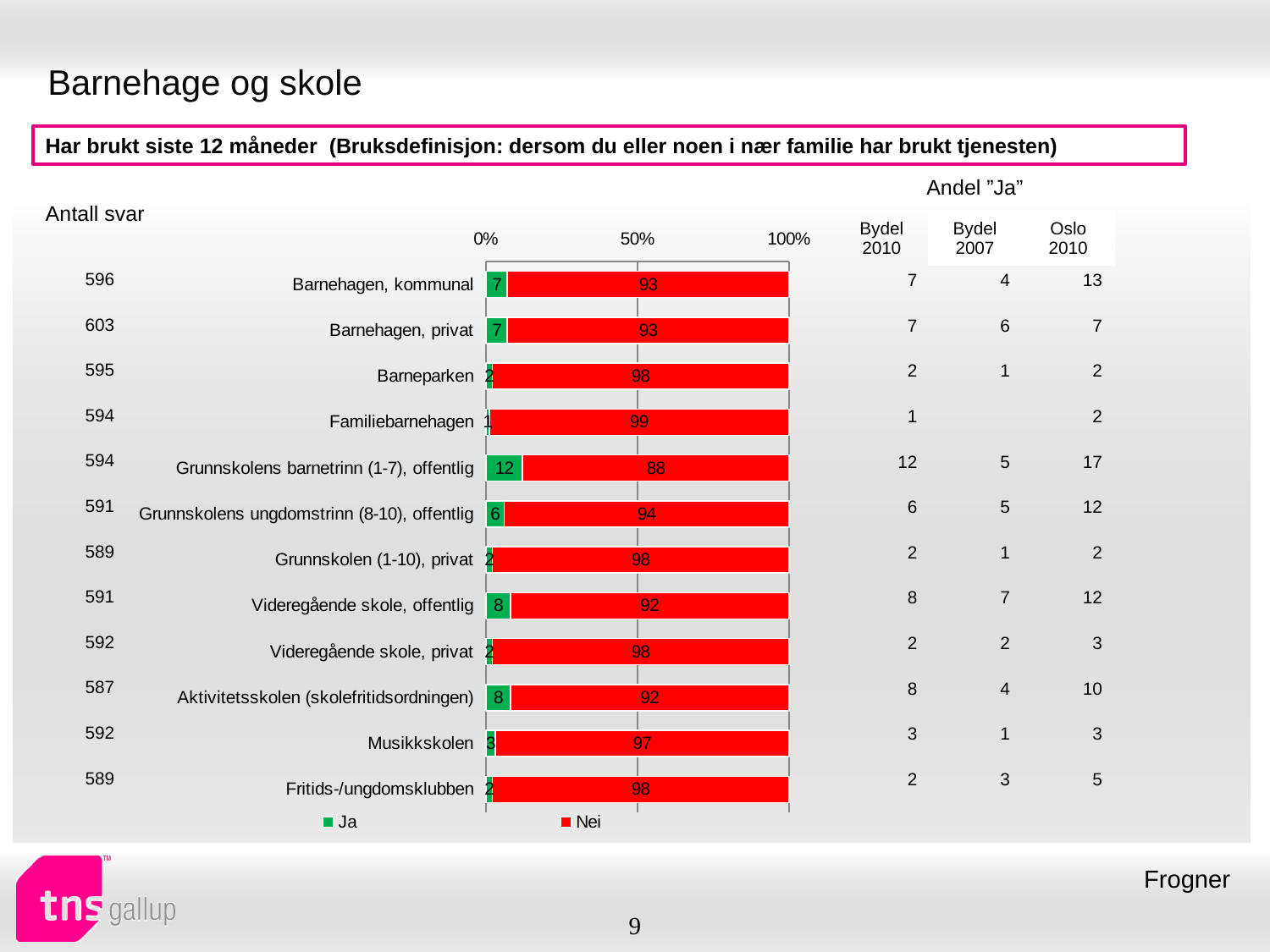
What kind of chart is shown on the slide? Stacked bar chart Which category has the highest "Ja" value? Grunnskolens barnetrinn (1-7), offentlig How many categories are shown in the bar chart? 12 Which category has the lowest "Ja" value? Familiebarnehagen Which has a larger "Ja" value, Barnehagen, kommunal or Musikkskolen? Barnehagen, kommunal What is the "Ja" value for Videregående skole, offentlig? 8 Is the "Nei" value for Barneparken greater or less than 50%? greater How many series does the legend list? 2 What is the "Nei" value for Musikkskolen? 97 What is the "Nei" value for Grunnskolens barnetrinn (1-7), offentlig? 88 What is the total of the stacked bar for Aktivitetsskolen (skolefritidsordningen)? 100 What is the difference between the "Ja" values for Grunnskolens barnetrinn (1-7), offentlig and Grunnskolens ungdomstrinn (8-10), offentlig? 6